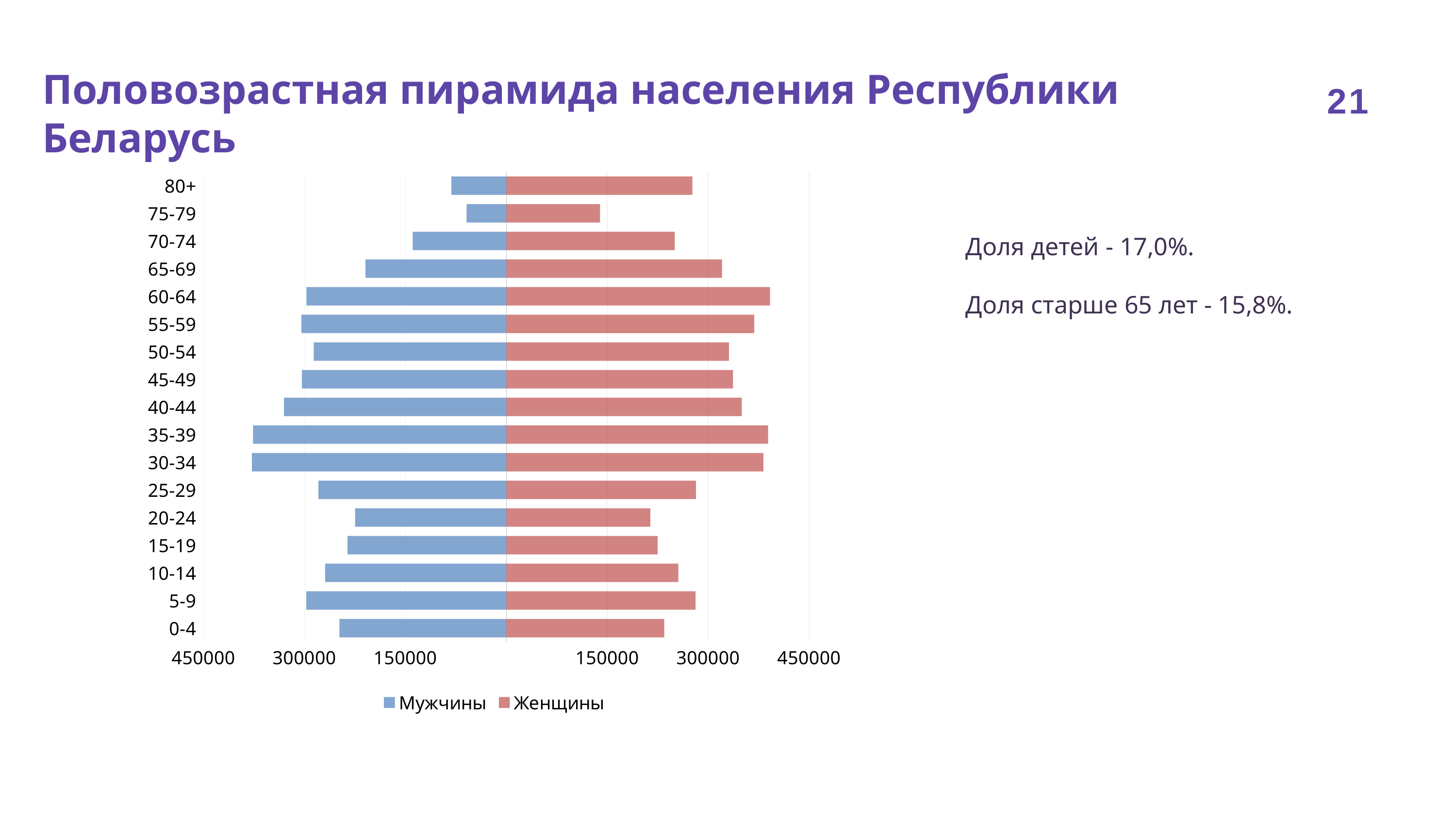
Is the value for Мужчины in the 80+ age group greater or less than 150000? less Is the value for Мужчины in the 35-39 age group greater or less than 300000? greater Which age group has the lowest value for Мужчины? 75-79 How many age groups are shown on the chart? 17 How many series does the legend list? 2 Which series is shown in blue on the chart? Мужчины Is the value for Женщины in the 80+ age group greater or less than 150000? greater Which age group has the lowest value for Женщины? 75-79 In the 65-69 age group, which is larger: Мужчины or Женщины? Женщины What kind of chart is shown on the slide? bar chart In the 80+ age group, which is larger: Мужчины or Женщины? Женщины